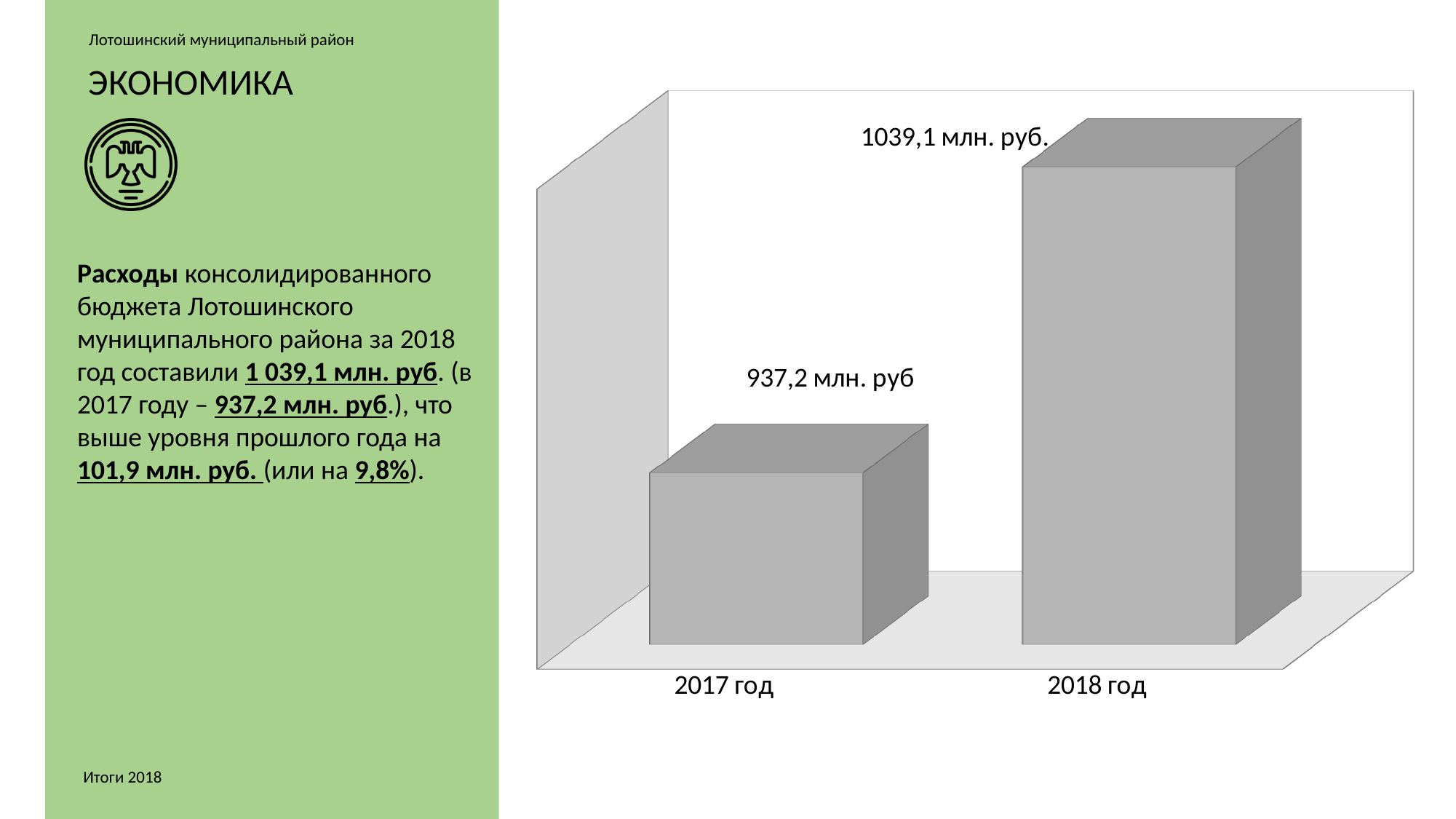
By how much does the 2018 год value exceed the 2017 год value? 101,9 млн. руб. What is the value shown for 2018 год? 1039,1 млн. руб. What unit are the data labels on the chart expressed in? млн. руб. Which year has the higher value? 2018 год Do the values rise or fall from 2017 год to 2018 год? rise What kind of chart is shown on the slide? bar chart Is the value for 2018 год larger or smaller than the value for 2017 год? larger What is the value shown for 2017 год? 937,2 млн. руб How many categories are plotted on the chart? 2 Which year has the lower value? 2017 год What colour are the bars on the chart? grey